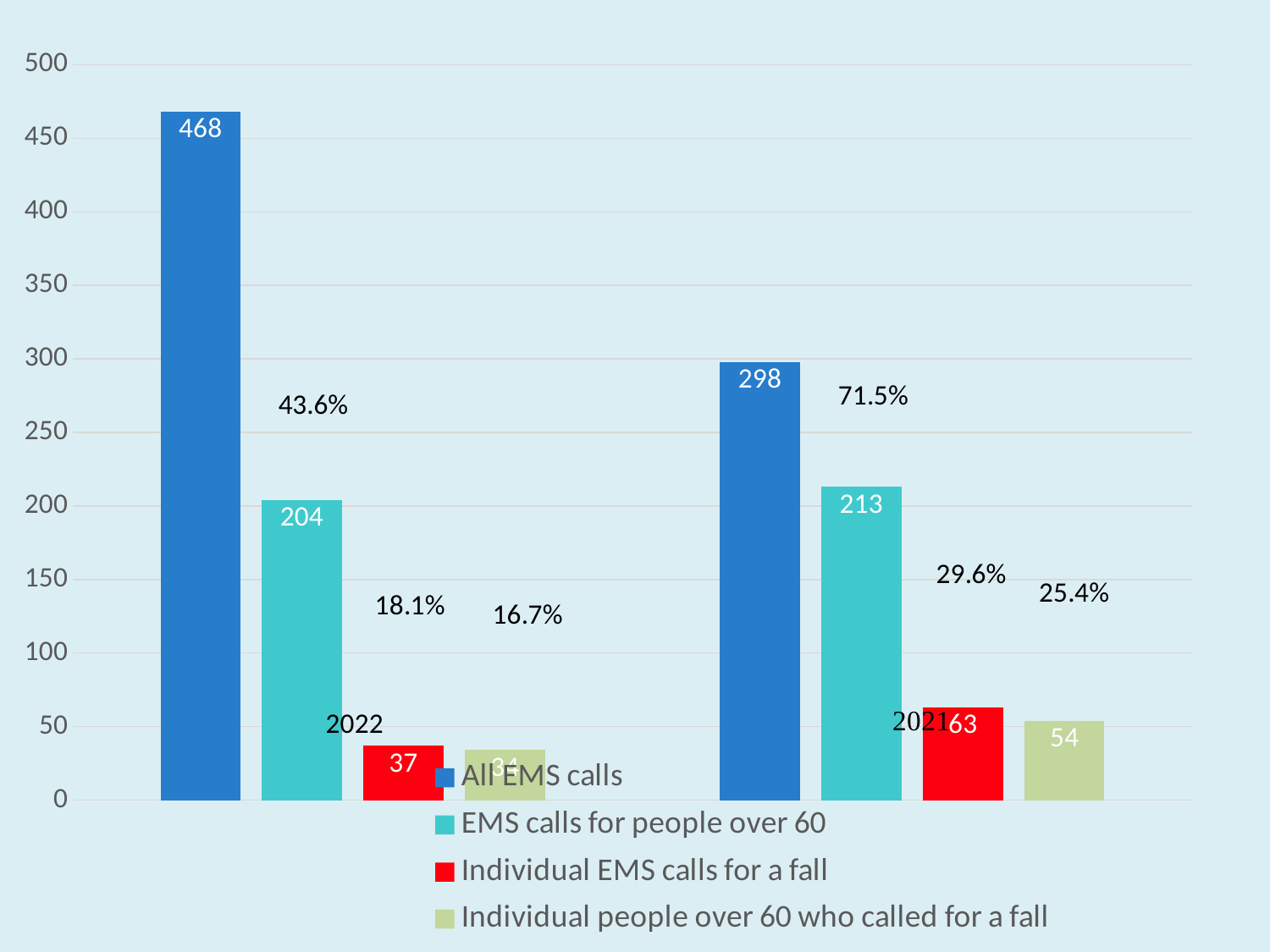
Which series has the highest value in 2022? All EMS calls What is the value for Individual people over 60 who called for a fall in 2021? 54 What is the value for Individual EMS calls for a fall in 2022? 37 What is the value for EMS calls for people over 60 in 2021? 213 What is the difference between All EMS calls in 2022 and All EMS calls in 2021? 170 What is the value for All EMS calls in 2022? 468 How many series does the legend list? 4 What kind of chart is shown on the slide? bar chart What colour are the bars for Individual EMS calls for a fall? red Which is larger: EMS calls for people over 60 in 2022 or in 2021? 2021 Is the value for All EMS calls in 2021 greater or less than 250? greater Which series has the lowest value in 2021? Individual people over 60 who called for a fall